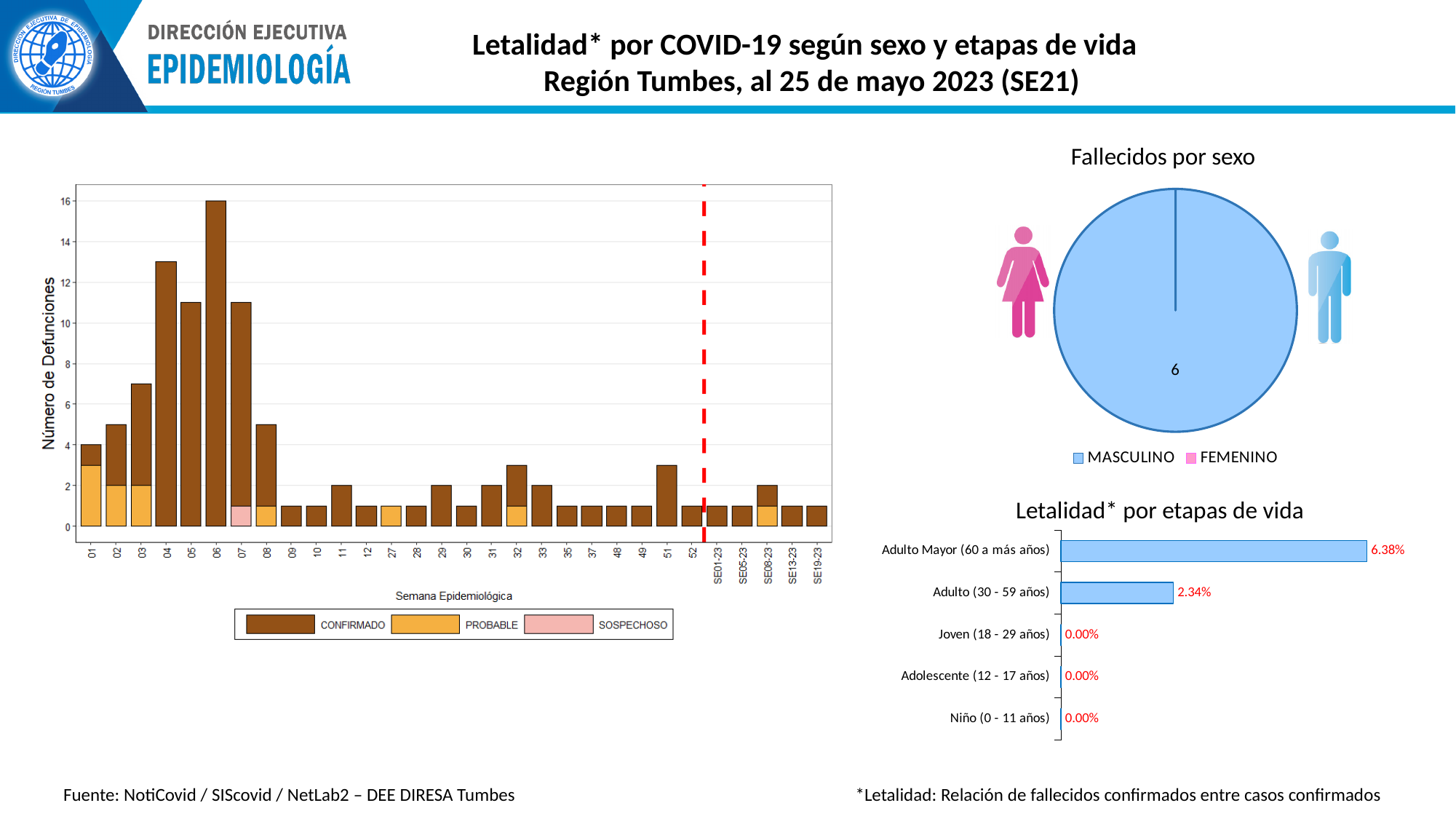
In the 'Fallecidos por sexo' pie chart, how many categories does the legend list? 2 In the 'Letalidad* por etapas de vida' chart, what is the difference between the values for Adulto Mayor (60 a más años) and Adulto (30 - 59 años)? 4.04% In the bar chart of deaths by epidemiological week (left), is the value for week 04 greater or less than 12? greater In the 'Fallecidos por sexo' pie chart, what value is shown for MASCULINO? 6 In the bar chart of deaths by epidemiological week (left), which colour represents CONFIRMADO? Brown In the bar chart of deaths by epidemiological week (left), how many series does the legend list? 3 In the bar chart of deaths by epidemiological week (left), which week has the highest number of deaths? 06 In the bar chart of deaths by epidemiological week (left), is the value for week 03 greater or less than 8? less In the 'Letalidad* por etapas de vida' chart, what is the value for Adulto Mayor (60 a más años)? 6.38% In the 'Letalidad* por etapas de vida' chart, what is the value for Adulto (30 - 59 años)? 2.34% In the bar chart of deaths by epidemiological week (left), what is the number of deaths in week 06? 16 In the 'Letalidad* por etapas de vida' chart, how many age-group categories are shown? 5